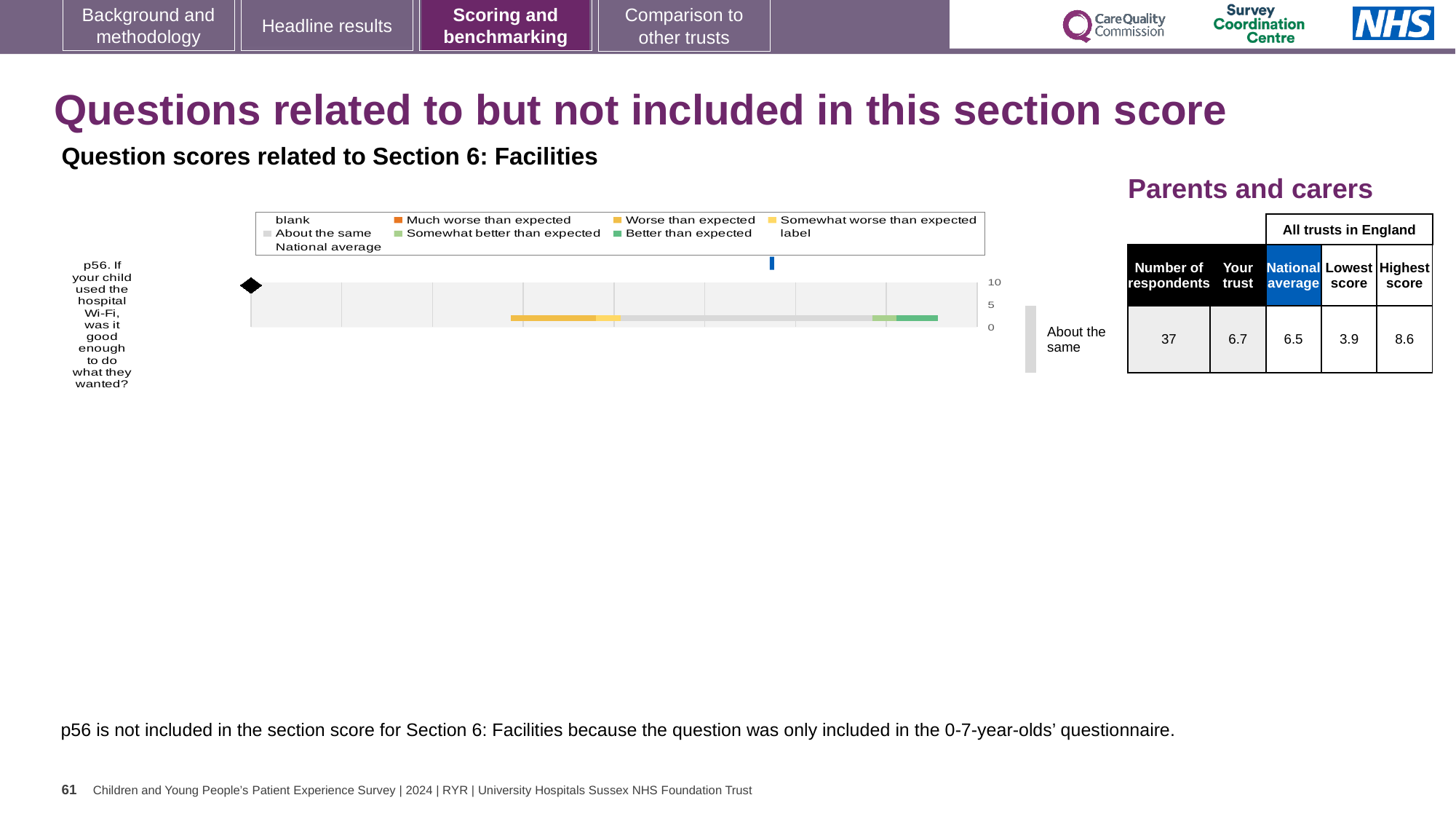
Which survey question is plotted on the chart? p56. If your child used the hospital Wi-Fi, was it good enough to do what they wanted? Which is larger for p56: the 'Your trust' score or the national average? Your trust What is the highest tick value shown on the chart's score axis? 10 How many respondents answered p56 according to the table beside the chart? 37 In the table beside the chart, what is the 'Your trust' score for p56? 6.7 In the table beside the chart, what is the lowest score among all trusts in England for p56? 3.9 How many survey questions are plotted on the chart? 1 In the table beside the chart, what is the national average score for p56? 6.5 In the table beside the chart, what is the highest score among all trusts in England for p56? 8.6 What kind of chart is shown on the slide? Bar chart What is the difference between the highest score and the lowest score for p56 in the table beside the chart? 4.7 Is the 'Your trust' score for p56 greater or less than 5? greater